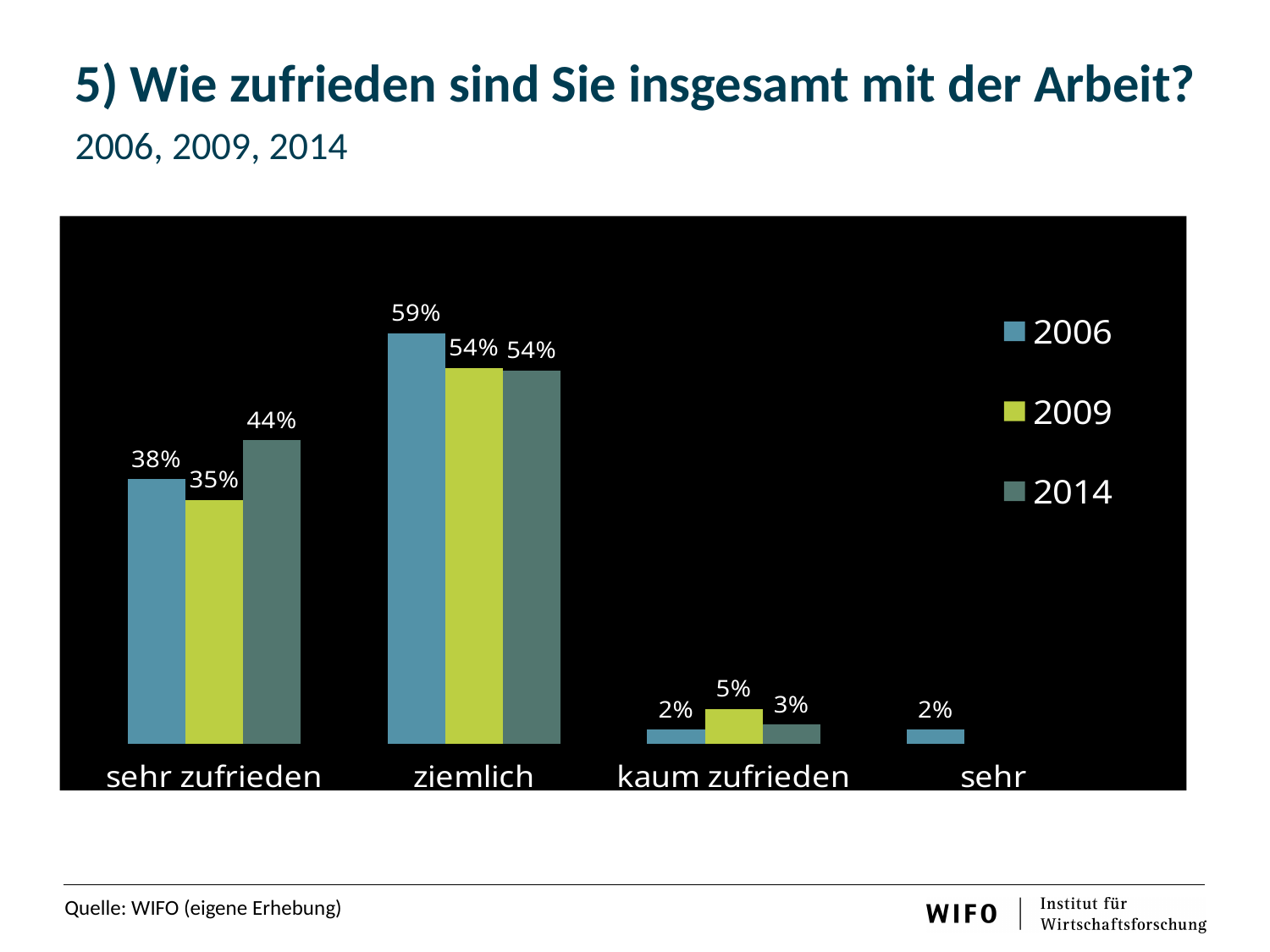
Which is larger in the "kaum zufrieden" category: the 2009 value or the 2014 value? 2009 Which category has the highest value for 2006? ziemlich Which year has the lowest value in the "sehr zufrieden" category? 2009 What kind of chart is shown on the slide? Bar chart What is the difference between the 2014 and 2006 values in the "sehr zufrieden" category? 6% What is the value for 2014 in the "sehr zufrieden" category? 44% Which years are listed in the chart legend? 2006, 2009, 2014 What is the value for 2006 in the "ziemlich" category? 59% What is the difference between the 2006 and 2009 values in the "ziemlich" category? 5% What is the value for 2009 in the "sehr zufrieden" category? 35% What is the value for 2009 in the "kaum zufrieden" category? 5% How many series does the legend list? 3